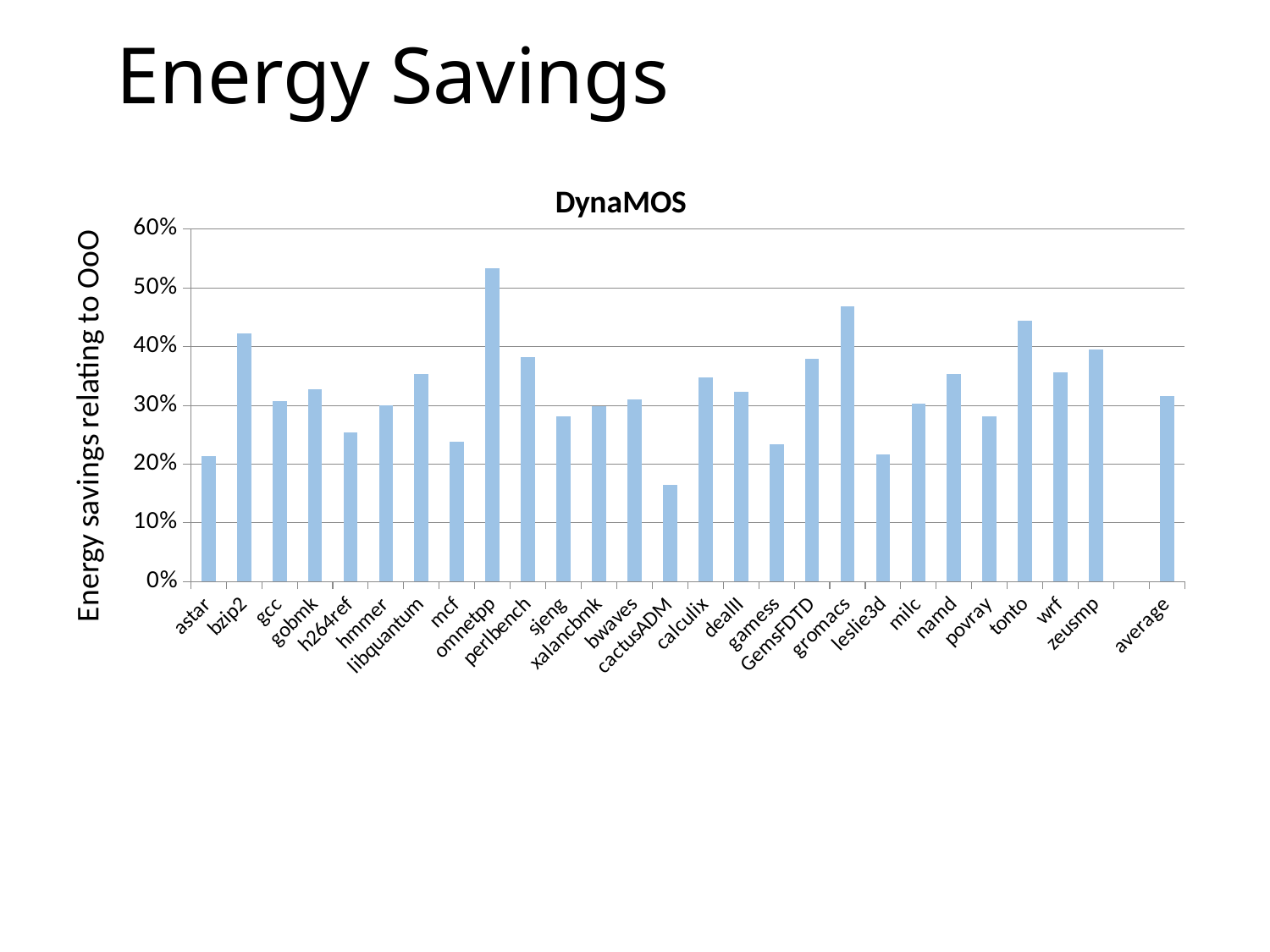
Which has the larger energy savings, bzip2 or gcc? bzip2 Is the value for gromacs greater or less than 40%? greater Which category has the lowest energy savings? cactusADM Which has the larger energy savings, omnetpp or gromacs? omnetpp Which category has the highest energy savings? omnetpp What is the label on the vertical axis of the chart? Energy savings relating to OoO What is the title of the chart? DynaMOS How many bars are plotted in the chart? 27 What kind of chart is shown on the slide? bar chart Is the value for omnetpp greater or less than 50%? greater Is the value for h264ref greater or less than 30%? less